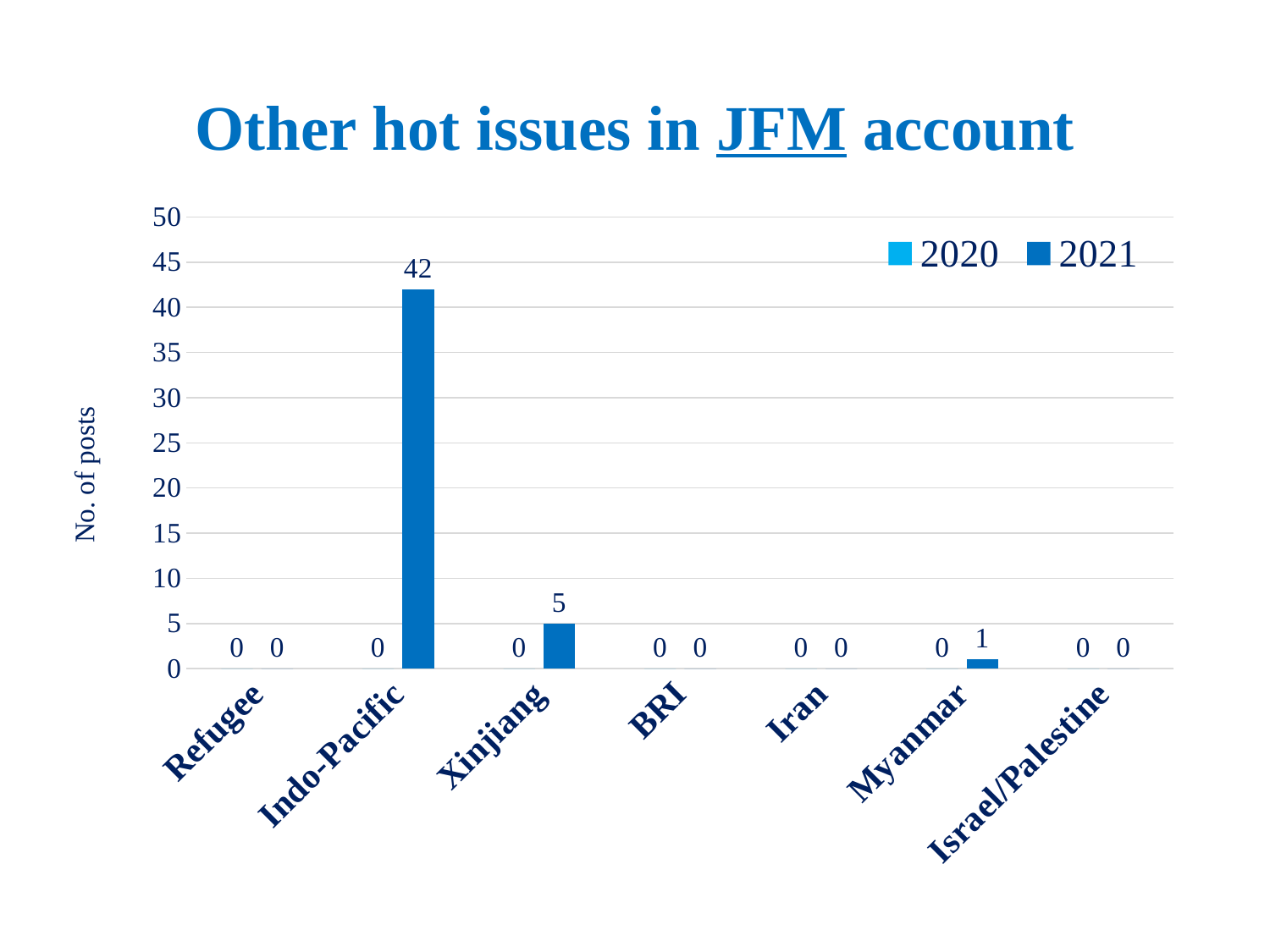
How many series does the legend list? 2 What is the value for Indo-Pacific in 2021? 42 What is the value for Myanmar in 2021? 1 Which is larger in 2021, Xinjiang or Myanmar? Xinjiang Which category has the highest value in 2021? Indo-Pacific What is the difference between the 2021 values for Indo-Pacific and Xinjiang? 37 What kind of chart is shown? bar chart How many categories are shown on the x axis? 7 What is the value for Indo-Pacific in 2020? 0 Is the 2021 value for Indo-Pacific greater or less than 40? greater What is the value for Xinjiang in 2021? 5 What is the title of the chart? Other hot issues in JFM account